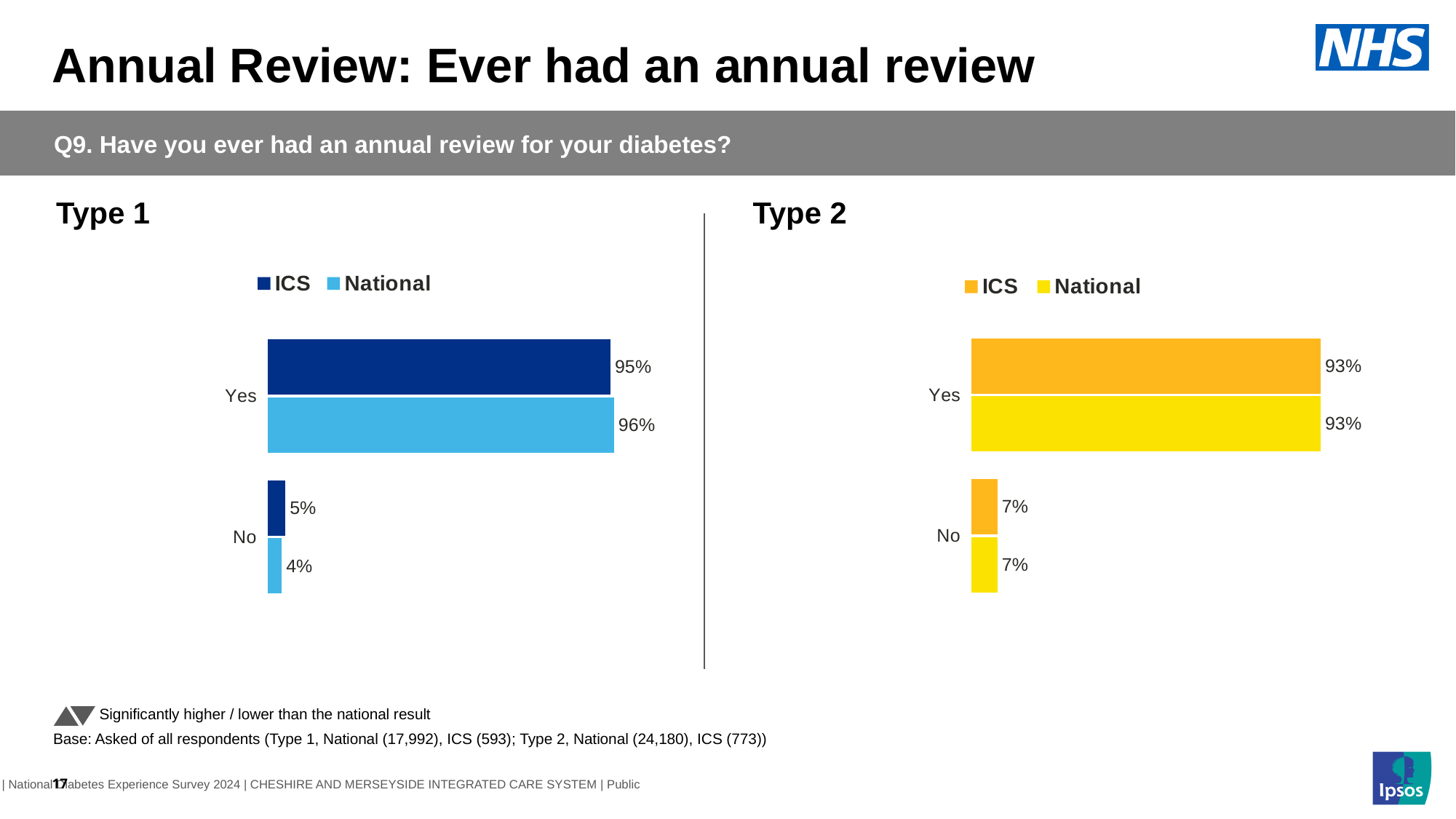
In the Type 1 chart, what is the difference between the National and ICS values for Yes? 1% How many categories are shown in the Type 1 chart? 2 In the Type 2 chart, which category has the highest ICS value? Yes In the Type 1 chart, what is the National value for No? 4% In the Type 2 chart, what is the ICS value for Yes? 93% In the Type 2 chart, what is the National value for No? 7% How many series does the legend of the Type 2 chart list? 2 In the Type 2 chart, what is the difference between the ICS and National values for Yes? 0% What kind of chart is the Type 1 chart? Bar chart In the Type 1 chart, what is the ICS value for Yes? 95% In the Type 1 chart, which category has the lowest National value? No In the Type 1 chart, which is larger for No: ICS or National? ICS